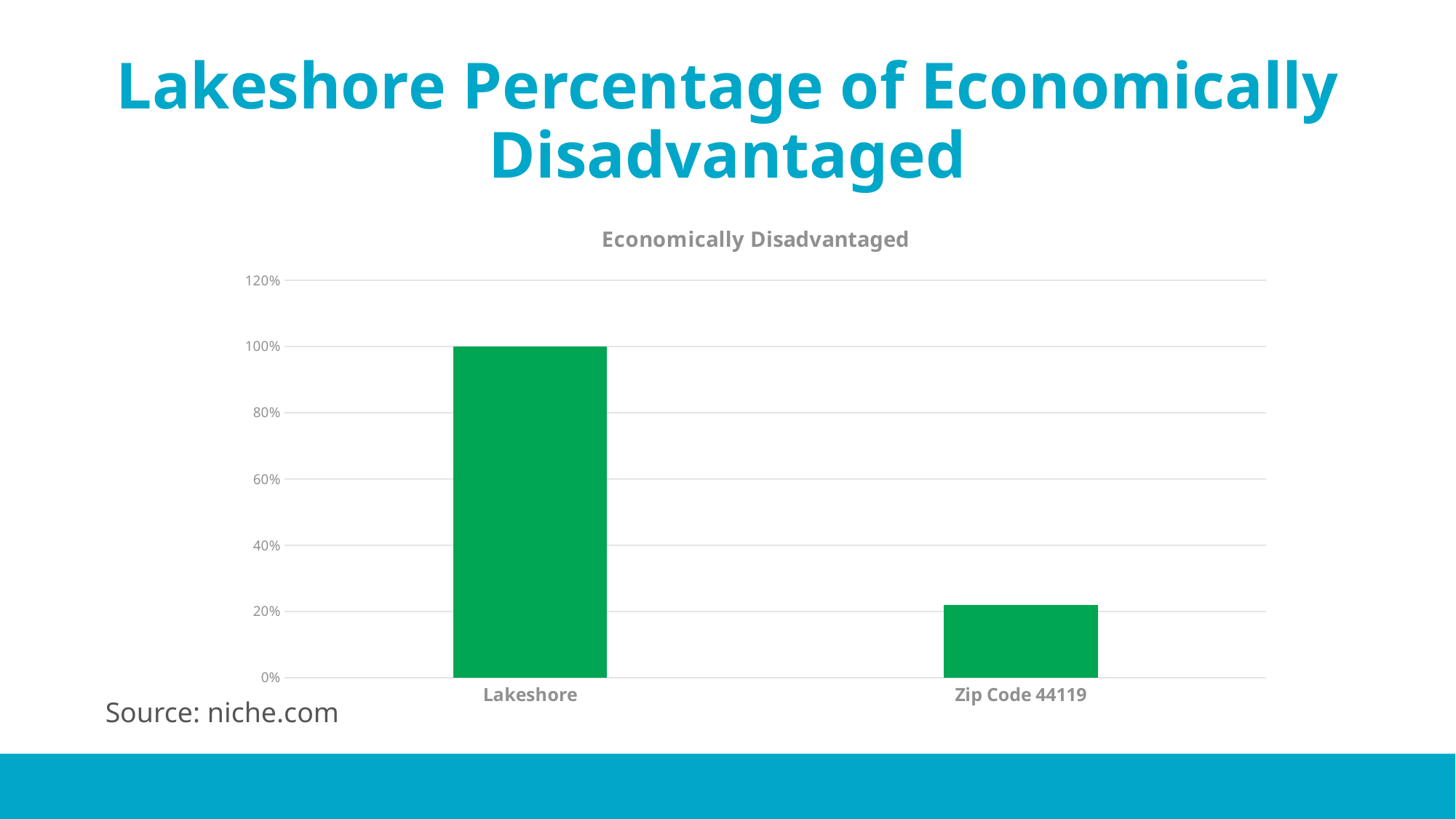
Is the value for Zip Code 44119 greater or less than 60%? less Is the value for Lakeshore greater or less than 80%? greater What is the title of the chart? Economically Disadvantaged Which category has the highest value? Lakeshore What type of chart is shown on the slide? Bar chart Which is larger, the value for Lakeshore or the value for Zip Code 44119? Lakeshore Do the values rise or fall from Lakeshore to Zip Code 44119 along the x axis? fall Which category has the lowest value? Zip Code 44119 How many categories are plotted in the chart? 2 What is the highest value shown on the vertical axis? 120% What is the value for Lakeshore? 100% Is the value for Zip Code 44119 greater or less than 40%? less